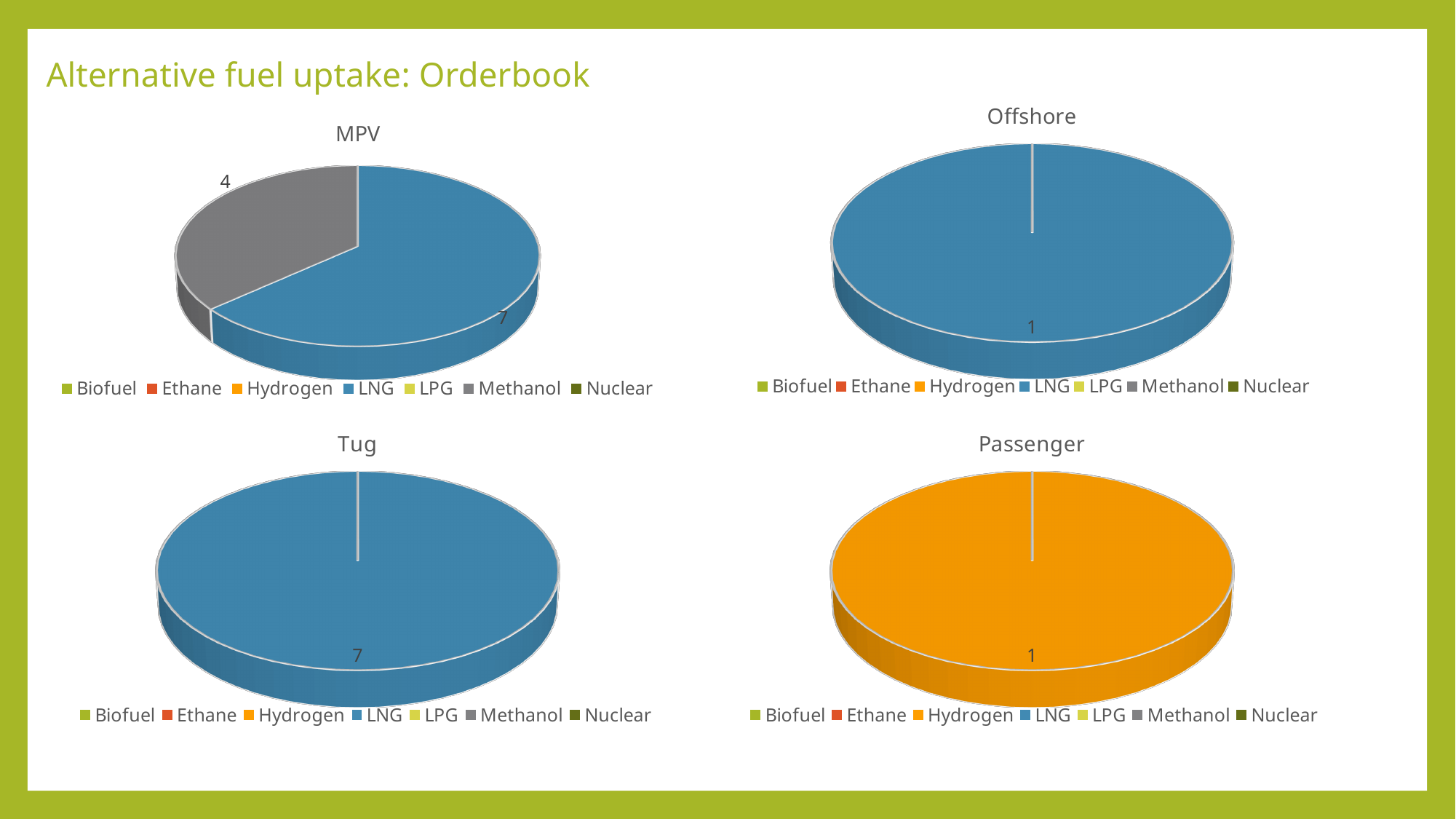
In the MPV chart, what is the difference between the LNG and Methanol values? 3 In the MPV chart, what is the value for Methanol? 4 In the MPV chart, what is the value for LNG? 7 What kind of chart is the Tug chart? Pie chart In the MPV chart, what is the total of the two slices shown? 11 In the Passenger chart, which fuel makes up the entire pie? Hydrogen How many entries does the legend of the Offshore chart list? 7 In the Passenger chart, what is the value for Hydrogen? 1 In the Offshore chart, what is the value for LNG? 1 In the Tug chart, what is the value for LNG? 7 What is the title of the slide? Alternative fuel uptake: Orderbook In the MPV chart, which fuel has the largest slice? LNG